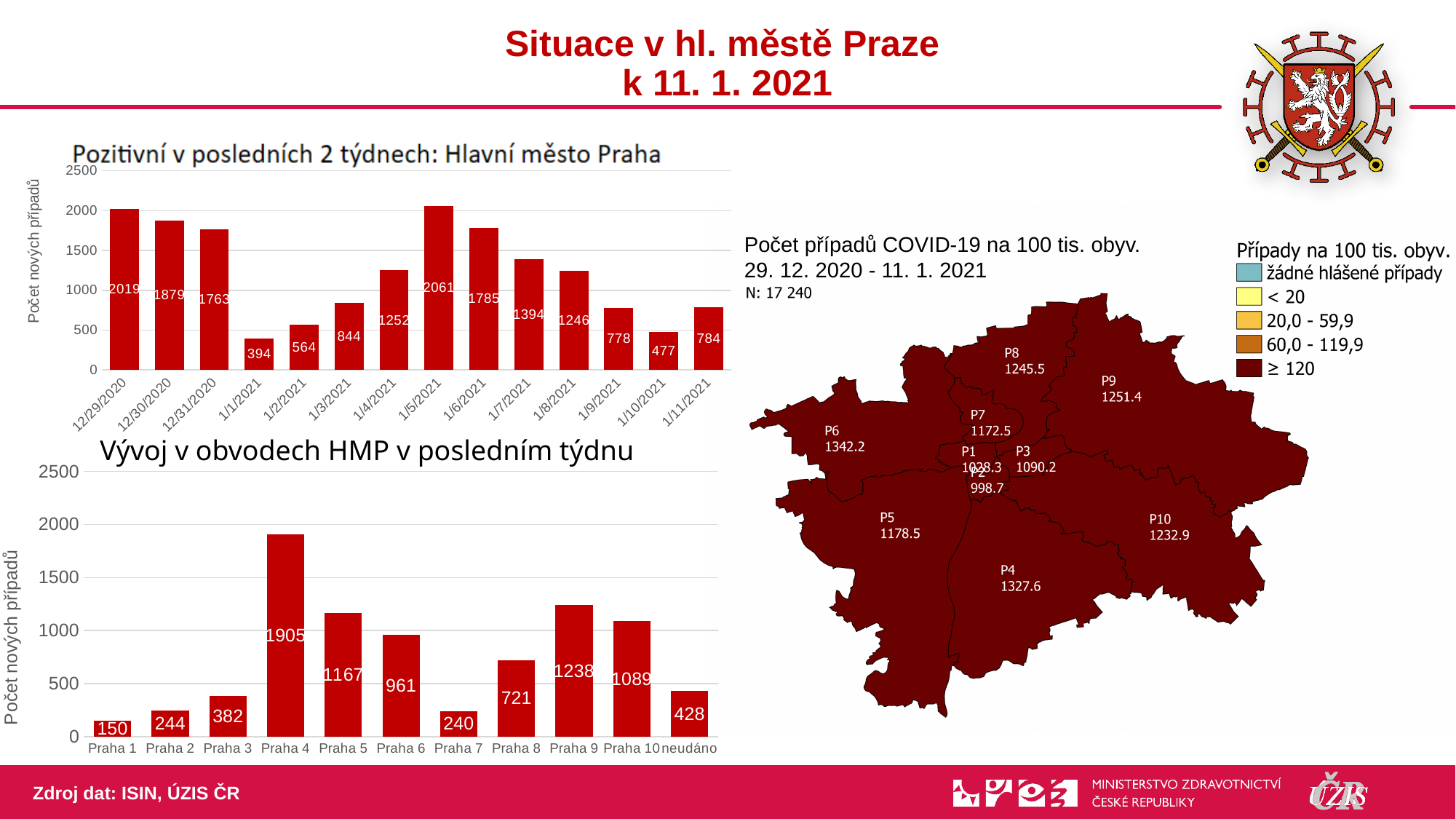
In the top chart 'Pozitivní v posledních 2 týdnech: Hlavní město Praha', what is the difference between the values for 12/29/2020 and 12/30/2020? 140 In the bottom chart 'Vývoj v obvodech HMP v posledním týdnu', what is the value for Praha 9? 1238 In the bottom chart 'Vývoj v obvodech HMP v posledním týdnu', what is the difference between the values for Praha 4 and Praha 9? 667 How many bars are shown in the top chart 'Pozitivní v posledních 2 týdnech: Hlavní město Praha'? 14 In the bottom chart 'Vývoj v obvodech HMP v posledním týdnu', which is larger: the value for Praha 5 or the value for Praha 10? Praha 5 How many categories are shown in the bottom chart 'Vývoj v obvodech HMP v posledním týdnu'? 11 In the top chart 'Pozitivní v posledních 2 týdnech: Hlavní město Praha', what is the value for 1/5/2021? 2061 In the top chart 'Pozitivní v posledních 2 týdnech: Hlavní město Praha', which date has the highest value? 1/5/2021 In the top chart 'Pozitivní v posledních 2 týdnech: Hlavní město Praha', which date has the lowest value? 1/1/2021 What type of chart is the bottom chart 'Vývoj v obvodech HMP v posledním týdnu'? bar chart In the bottom chart 'Vývoj v obvodech HMP v posledním týdnu', which category has the lowest value? Praha 1 In the bottom chart 'Vývoj v obvodech HMP v posledním týdnu', which category has the highest value? Praha 4